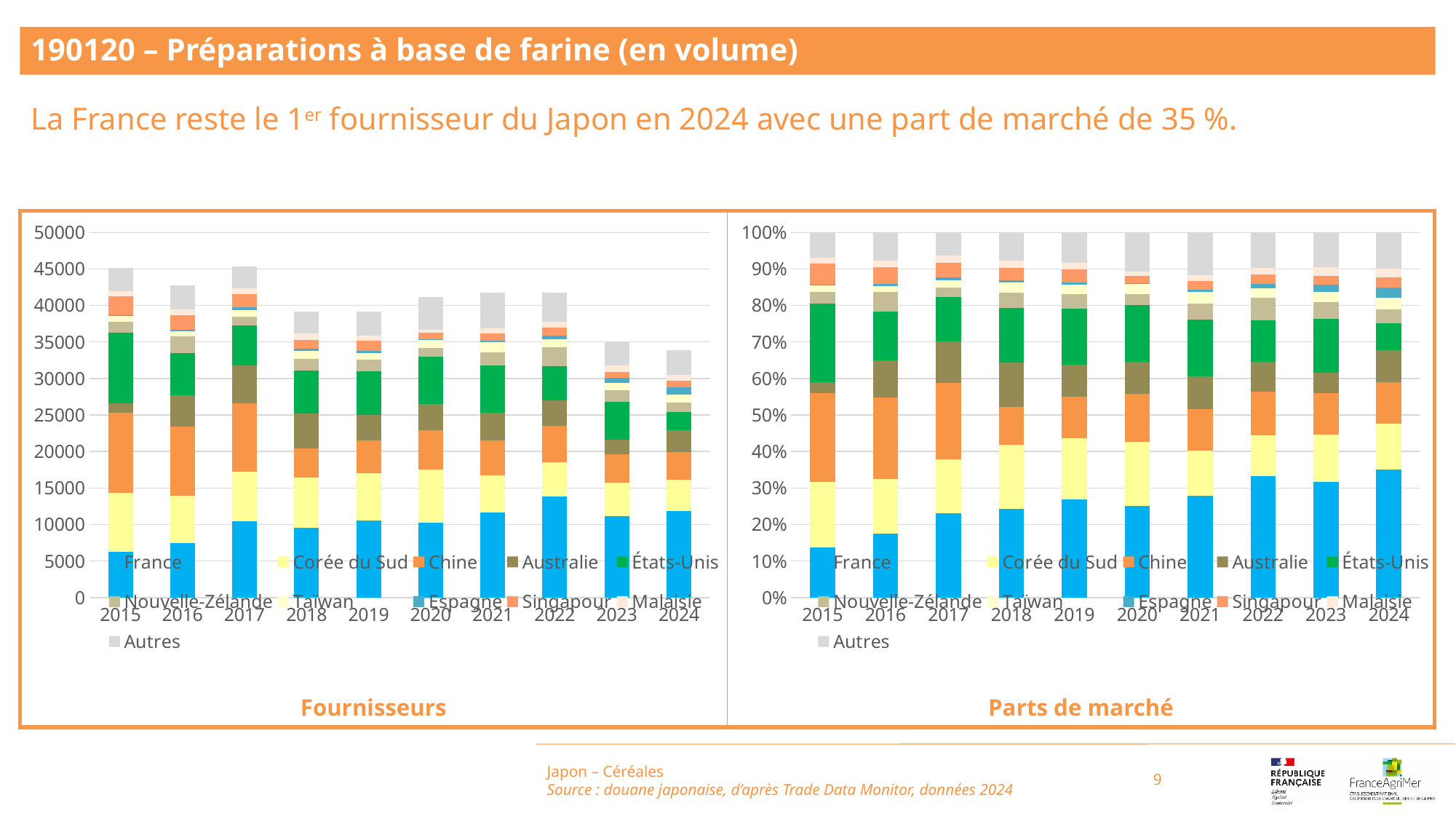
In the 'Fournisseurs' chart, how many years are shown on the x axis? 10 In the 'Parts de marché' chart, is the share for France in 2015 greater or less than 20%? less In the 'Parts de marché' chart, how many series does the legend list? 11 Which series is shown in blue at the bottom of the stacked bars in both charts? France In the 'Parts de marché' chart, is the share for France in 2024 greater or less than 30%? greater In the 'Parts de marché' chart, is France's share larger in 2015 or in 2024? 2024 What kind of chart is the 'Fournisseurs' chart on the left? stacked bar chart In the 'Fournisseurs' chart, is the value for France in 2024 greater or less than 10000? greater In the 'Parts de marché' chart, does France's share generally rise or fall from 2015 to 2024? rise What kind of chart is the 'Parts de marché' chart on the right? 100% stacked bar chart